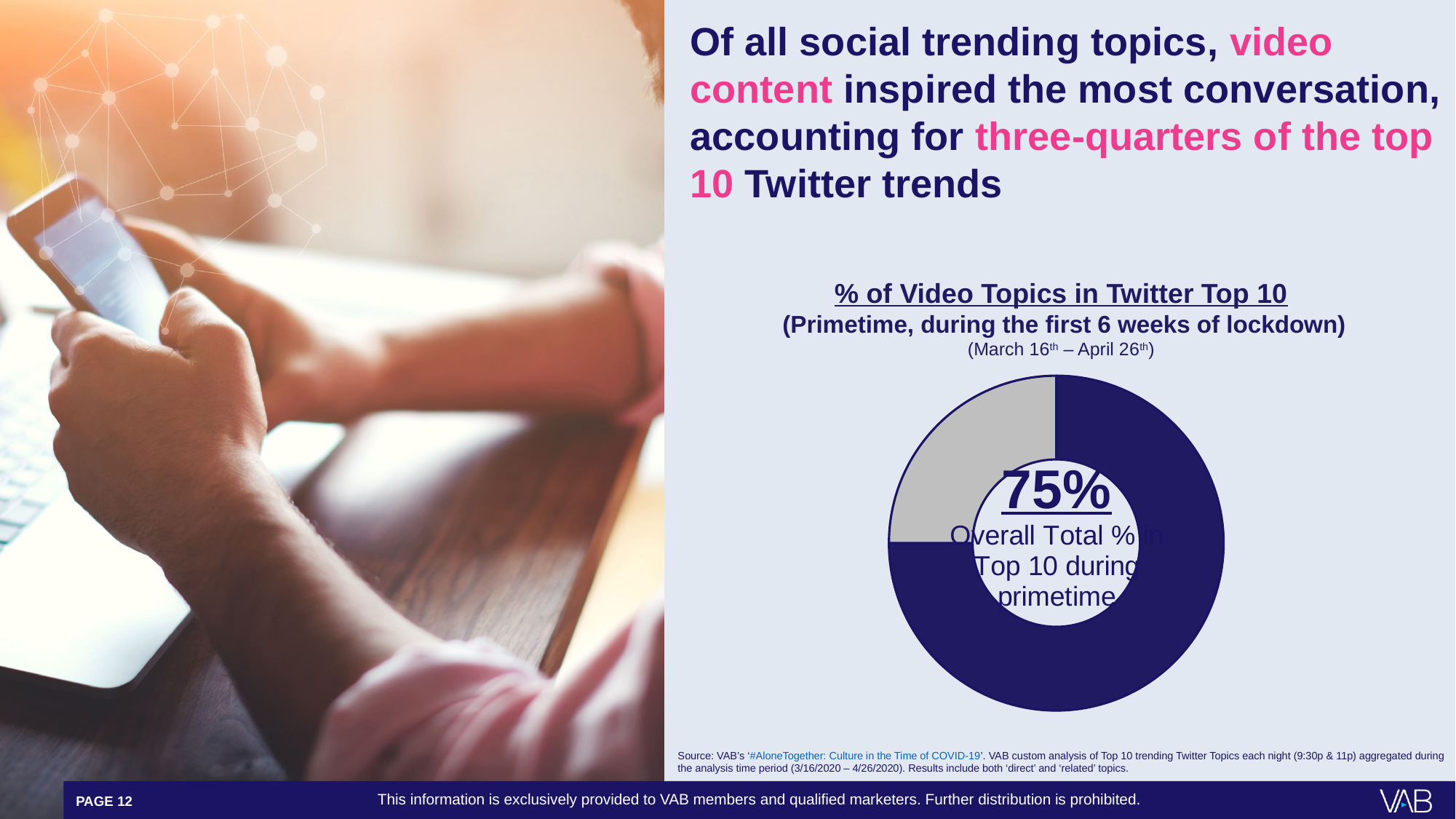
What percentage of video topics in the Twitter Top 10 is shown in the donut chart? 75% Which segment of the donut chart is larger, the dark blue one or the grey one? the dark blue one What share of the donut chart does the dark blue segment represent? 75% Is the grey segment of the donut chart greater or less than 50%? less What is the title of the chart? % of Video Topics in Twitter Top 10 Is the value shown for video topics in the Twitter Top 10 greater or less than 50%? greater What kind of chart is shown on the slide? pie chart (donut) What label appears inside the centre of the donut chart below the 75% figure? Overall Total % in Top 10 during primetime How many segments does the donut chart have? 2